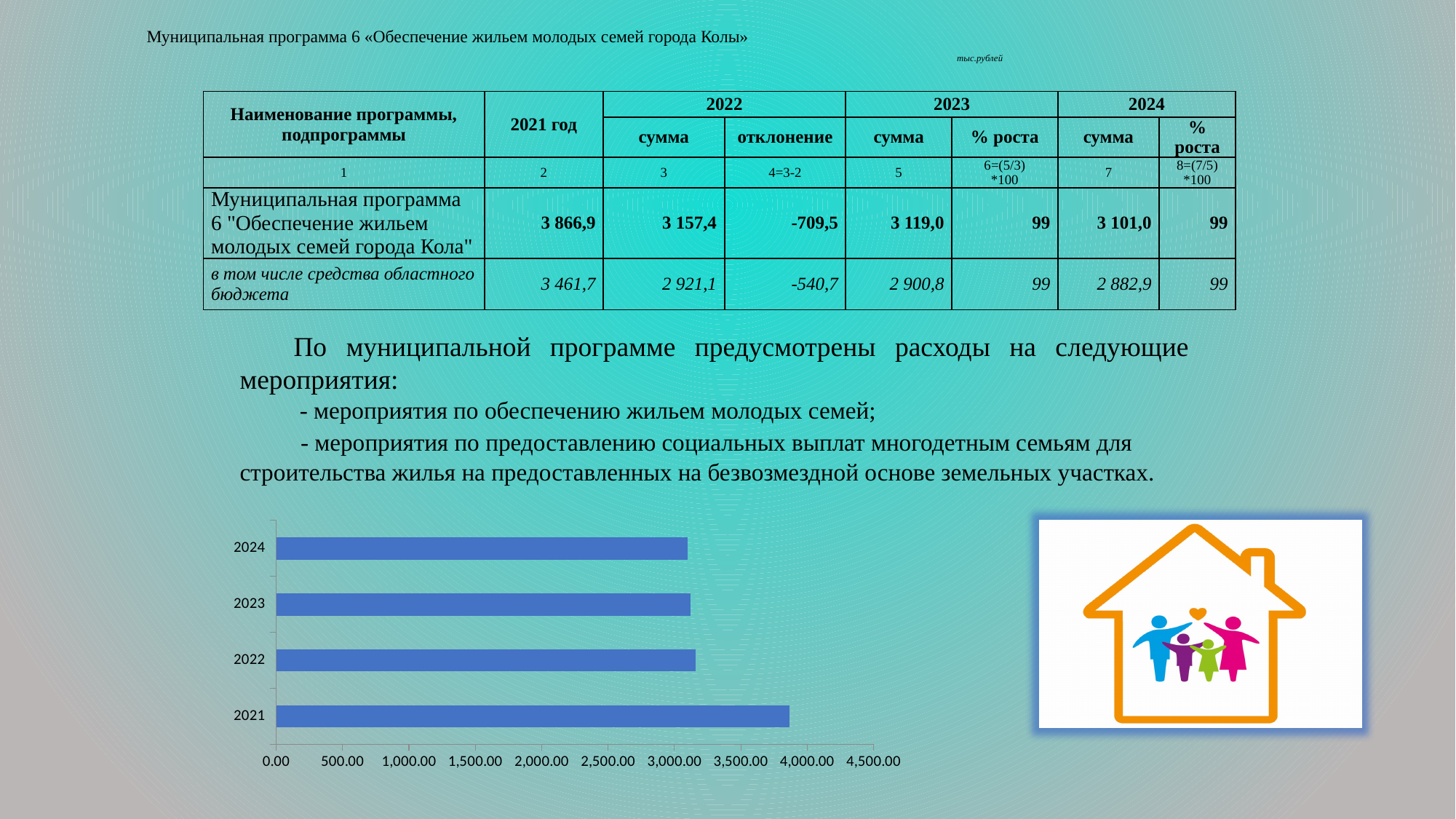
What colour are the bars in the chart? blue Which bar is longer, 2021 or 2022? 2021 Is the bar for 2024 greater or less than 3,500.00? less Which bar is longer, 2021 or 2024? 2021 Do the bars get shorter or longer going from 2021 to 2024? shorter How many years (categories) are plotted in the bar chart? 4 Is the bar for 2022 greater or less than 3,000.00? greater Which year has the longest bar in the chart? 2021 Is the bar for 2021 greater or less than 3,500.00? greater What is the highest value shown on the chart's horizontal axis? 4,500.00 What kind of chart is shown at the bottom left of the slide? bar chart